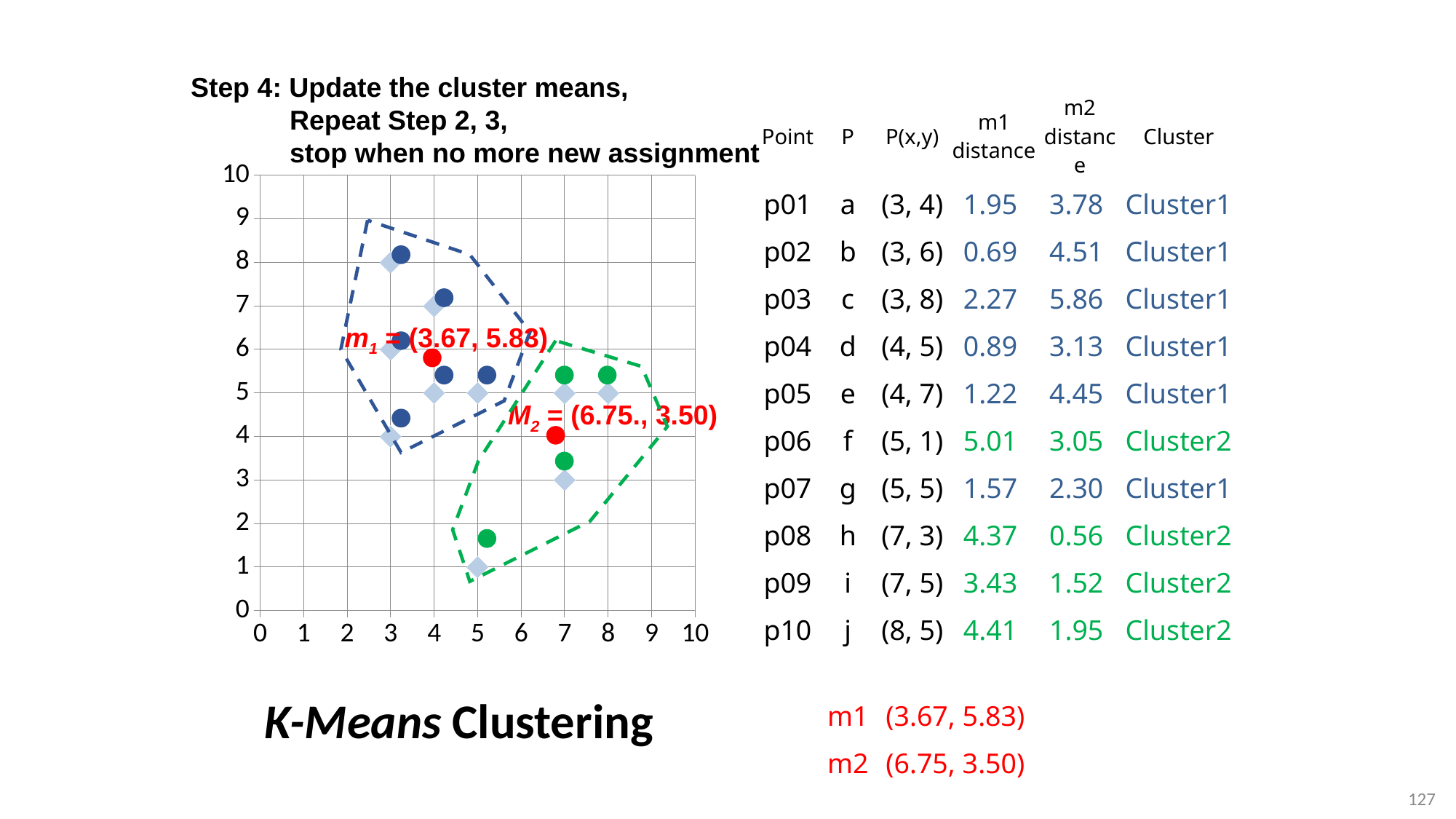
What is the maximum value shown on the chart's x axis? 10 What is the m1 distance for point p02? 0.69 What are the coordinates P(x,y) of point h? (7, 3) Which point has the largest m2 distance? p03 What kind of chart is shown on the left of the slide? scatter chart For point p07, which is larger: the m1 distance or the m2 distance? m2 distance What are the coordinates of cluster mean m1 as labeled on the chart? (3.67, 5.83) How many data points (p01 to p10) are plotted in the chart? 10 Which point has the smallest m1 distance? p02 What are the coordinates of cluster mean m2 as labeled on the chart? (6.75, 3.50) What is the difference between the m1 distance and the m2 distance for point p08? 3.81 How many points are assigned to Cluster2? 4